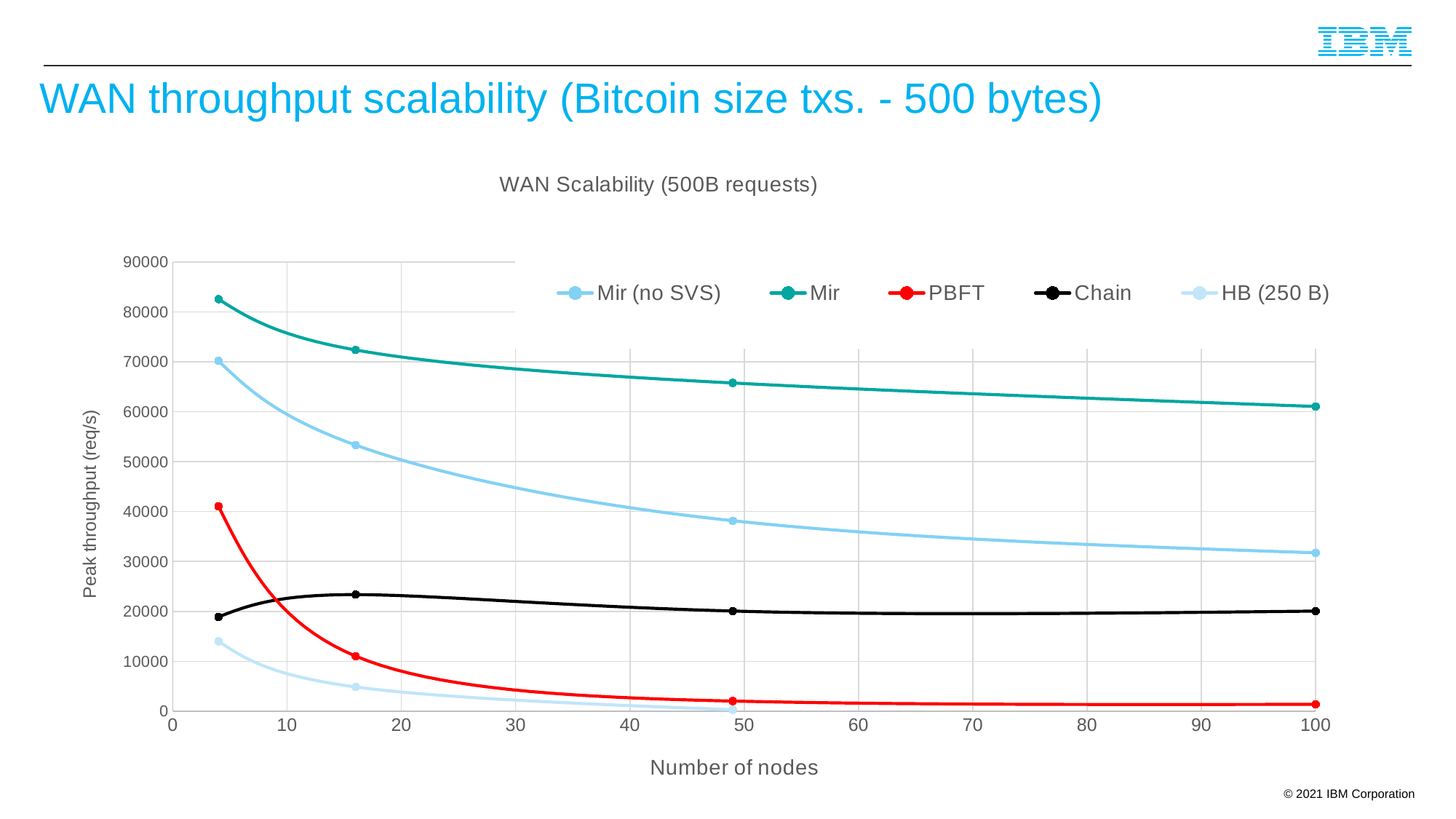
At about 16 nodes, which series has the higher peak throughput, Chain or PBFT? Chain Which series has the highest peak throughput at 100 nodes? Mir Which series has the lowest peak throughput at 100 nodes? PBFT Is the peak throughput of PBFT at its first plotted point (about 4 nodes) greater or less than 30000? greater Is the peak throughput of Mir at 100 nodes greater or less than 50000? greater Is the peak throughput of Mir (no SVS) at 100 nodes greater or less than 40000? less Does the peak throughput of Mir (no SVS) rise or fall as the number of nodes increases? falls What is the title of the chart? WAN Scalability (500B requests) How many data points are plotted for the Mir series? 4 What kind of chart is shown on the slide? line chart How many series does the legend list? 5 What is the label of the y axis? Peak throughput (req/s)